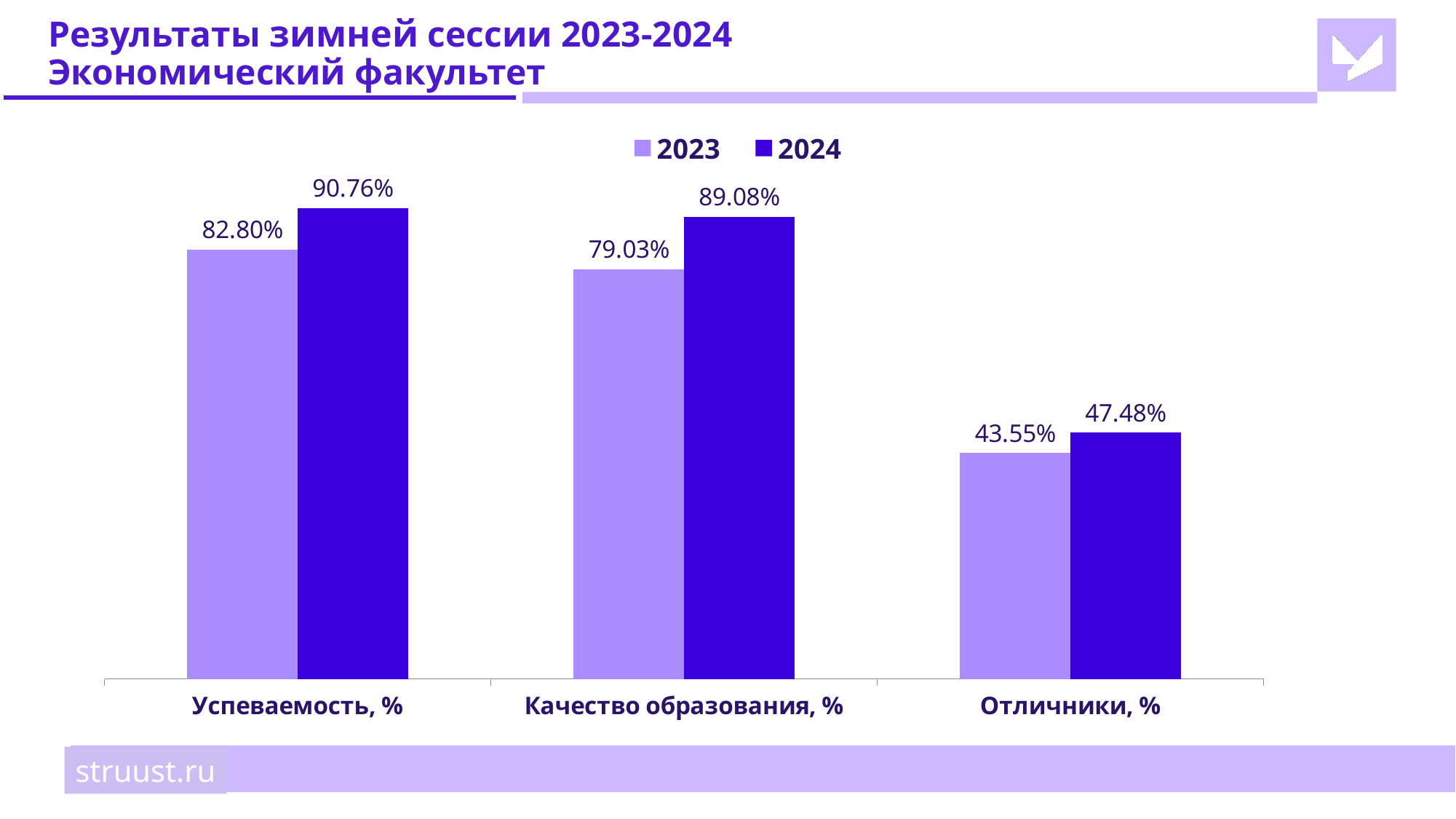
How many categories are shown on the x axis? 3 What is the difference between the 2024 and 2023 values for Качество образования, %? 10.05% What kind of chart is shown on the slide? Bar chart What is the value for Успеваемость, % in 2024? 90.76% What is the value for Отличники, % in 2023? 43.55% What is the difference between the 2024 and 2023 values for Успеваемость, %? 7.96% Which category has the highest value in 2024? Успеваемость, % Which category has the lowest value in 2023? Отличники, % Which is larger for Отличники, %: the 2023 value or the 2024 value? 2024 How many series does the legend list? 2 What is the value for Качество образования, % in 2023? 79.03% Which series is shown in the darker purple colour? 2024